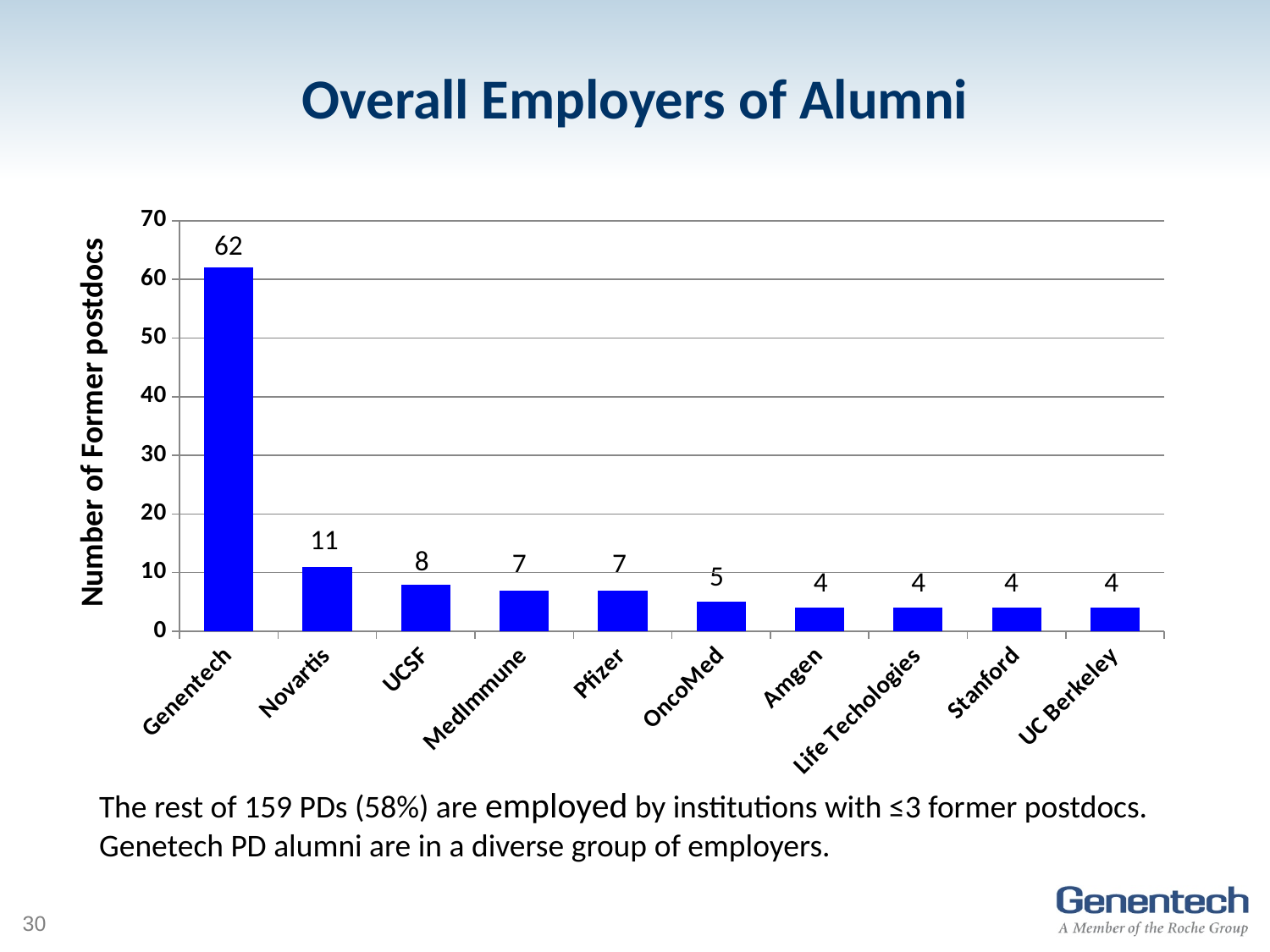
Which has more former postdocs, MedImmune or OncoMed? MedImmune What type of chart is shown on the slide? bar chart How many former postdocs are employed at Genentech? 62 Do the values rise or fall moving from left to right along the x axis? fall What is the difference between the number of former postdocs at Genentech and at Novartis? 51 What is the number of former postdocs at Novartis? 11 Is the value for Genentech greater or less than 60? greater What is the label of the y axis of the chart? Number of Former postdocs How many employers are shown on the x axis of the chart? 10 How many former postdocs does OncoMed employ? 5 What is the difference between the number of former postdocs at UCSF and at Amgen? 4 Which employer has the highest number of former postdocs? Genentech